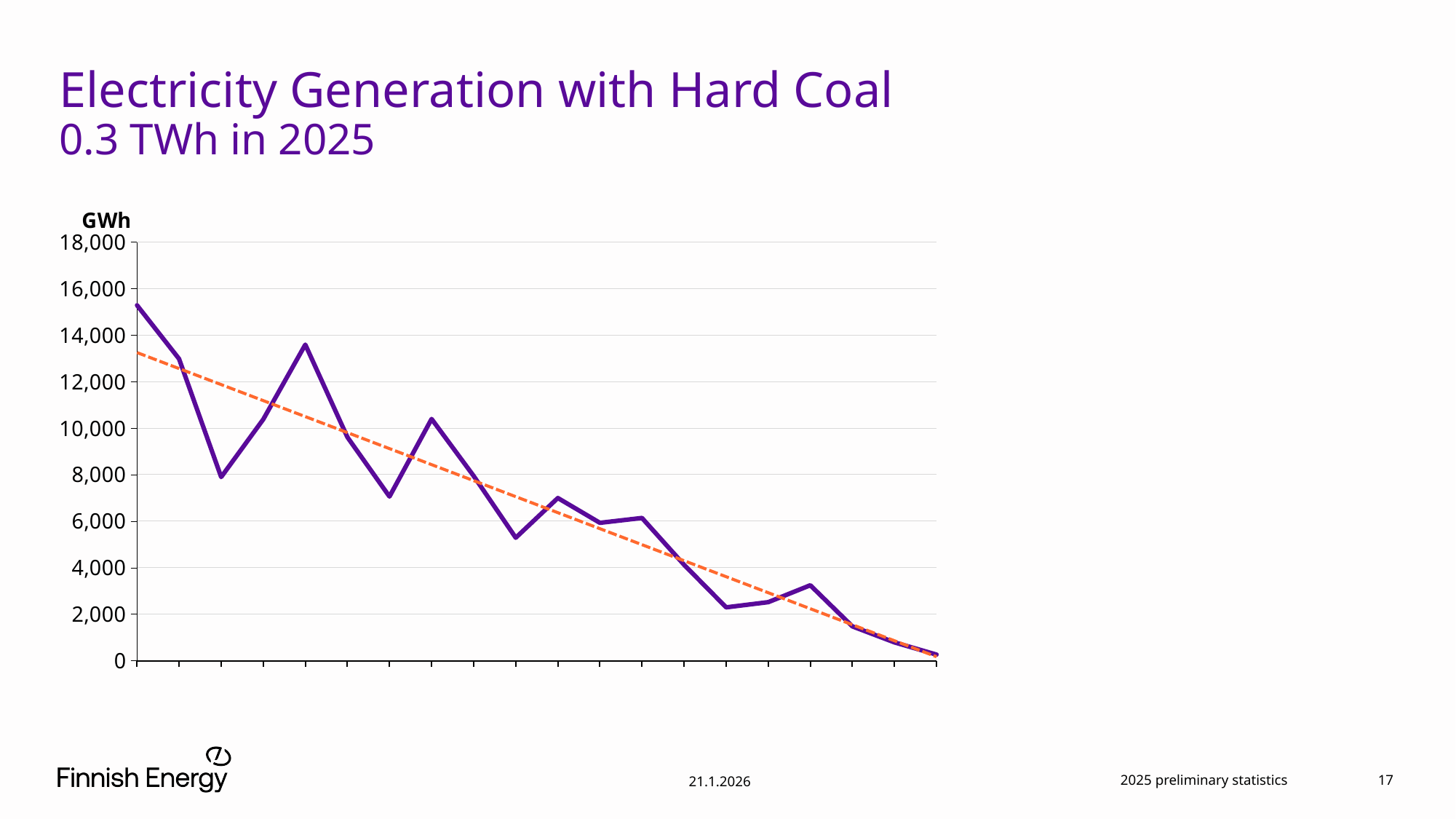
What kind of chart is shown on the slide? line chart Is the value of the last point on the solid line greater or less than 2,000? less What is the title of the chart on the slide? Electricity Generation with Hard Coal Is the value of the first point on the solid line greater or less than 16,000? less What is the highest value shown on the y axis of the chart? 18,000 Is the lowest point of the solid line at the start or at the end of the x axis? at the end Do the values in the chart generally rise or fall along the x axis? fall What unit is shown on the y axis of the chart? GWh Is the value of the first point on the solid line greater or less than 14,000? greater Which point on the solid line is the highest, the first or the last? the first According to the subtitle, how much electricity was generated with hard coal in 2025? 0.3 TWh